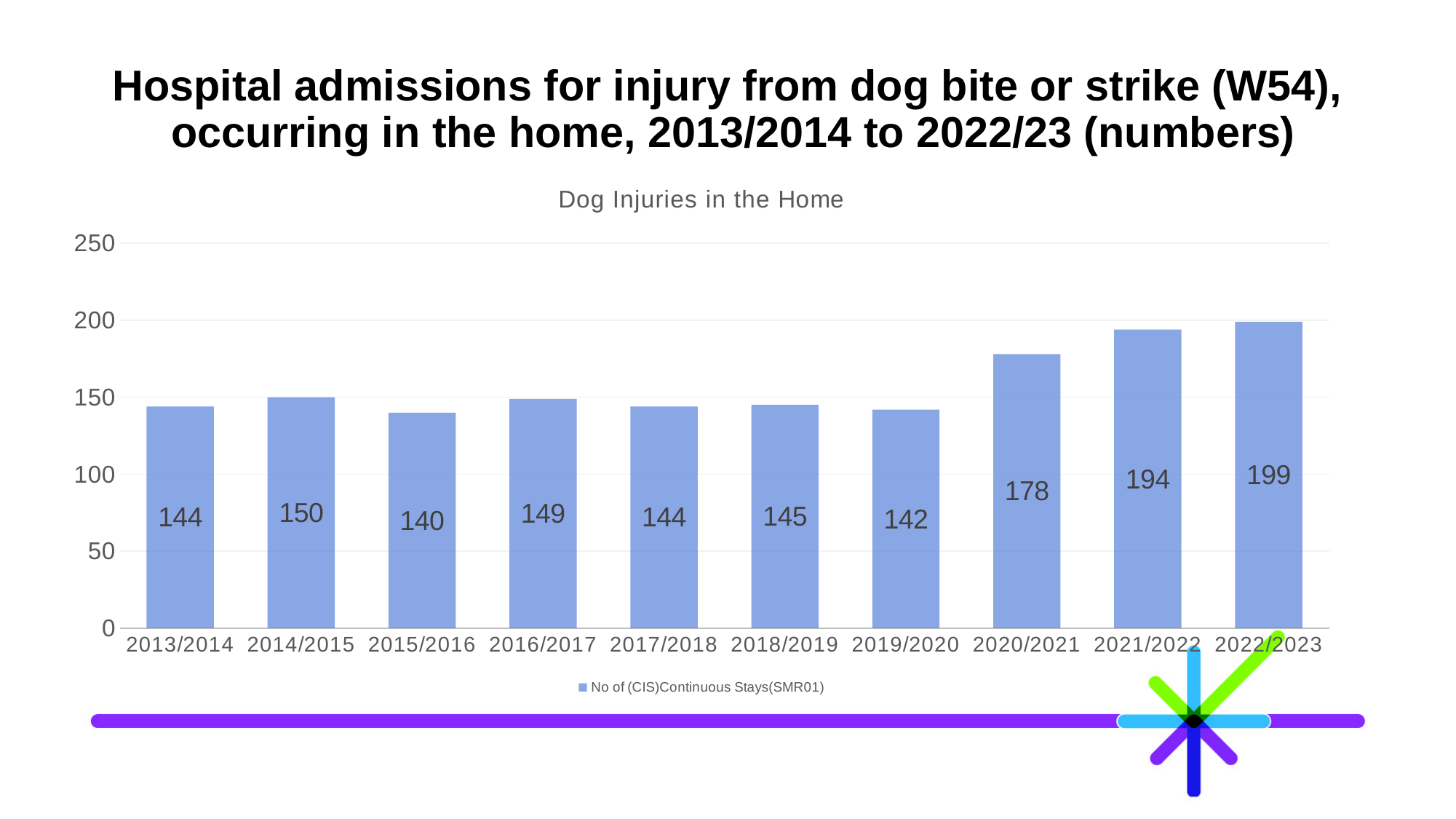
What is the value for 2022/2023? 199 Which is larger, the value for 2014/2015 or the value for 2019/2020? 2014/2015 Is the value for 2021/2022 greater or less than 150? greater How many years are shown on the x axis? 10 What is the value for 2015/2016? 140 What is the value for 2020/2021? 178 Which year has the lowest value? 2015/2016 Which year has the highest value? 2022/2023 What is the difference between the values for 2022/2023 and 2013/2014? 55 What kind of chart is shown? bar chart What is the series name shown in the legend? No of (CIS)Continuous Stays(SMR01) What is the difference between the values for 2021/2022 and 2020/2021? 16